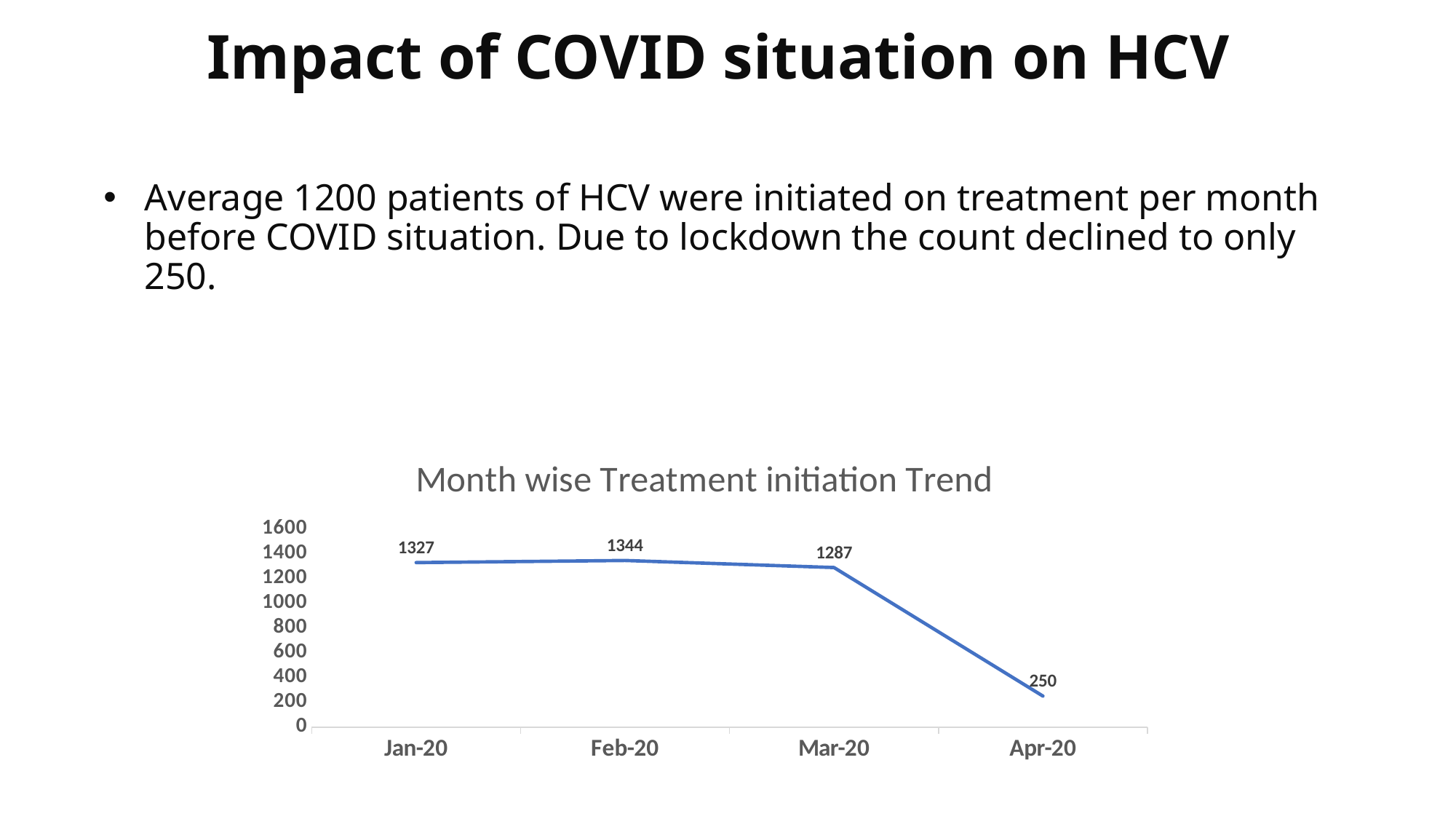
What is the difference between the values for Feb-20 and Jan-20? 17 What is the difference between the values for Mar-20 and Apr-20? 1037 Which is larger, the value for Jan-20 or the value for Mar-20? Jan-20 What is the title of the chart? Month wise Treatment initiation Trend Which month has the highest value? Feb-20 What is the value for Feb-20? 1344 How many months are plotted on the chart? 4 What is the value for Mar-20? 1287 Which month has the lowest value? Apr-20 What is the value for Apr-20? 250 What kind of chart is shown on the slide? line chart What is the value for Jan-20? 1327